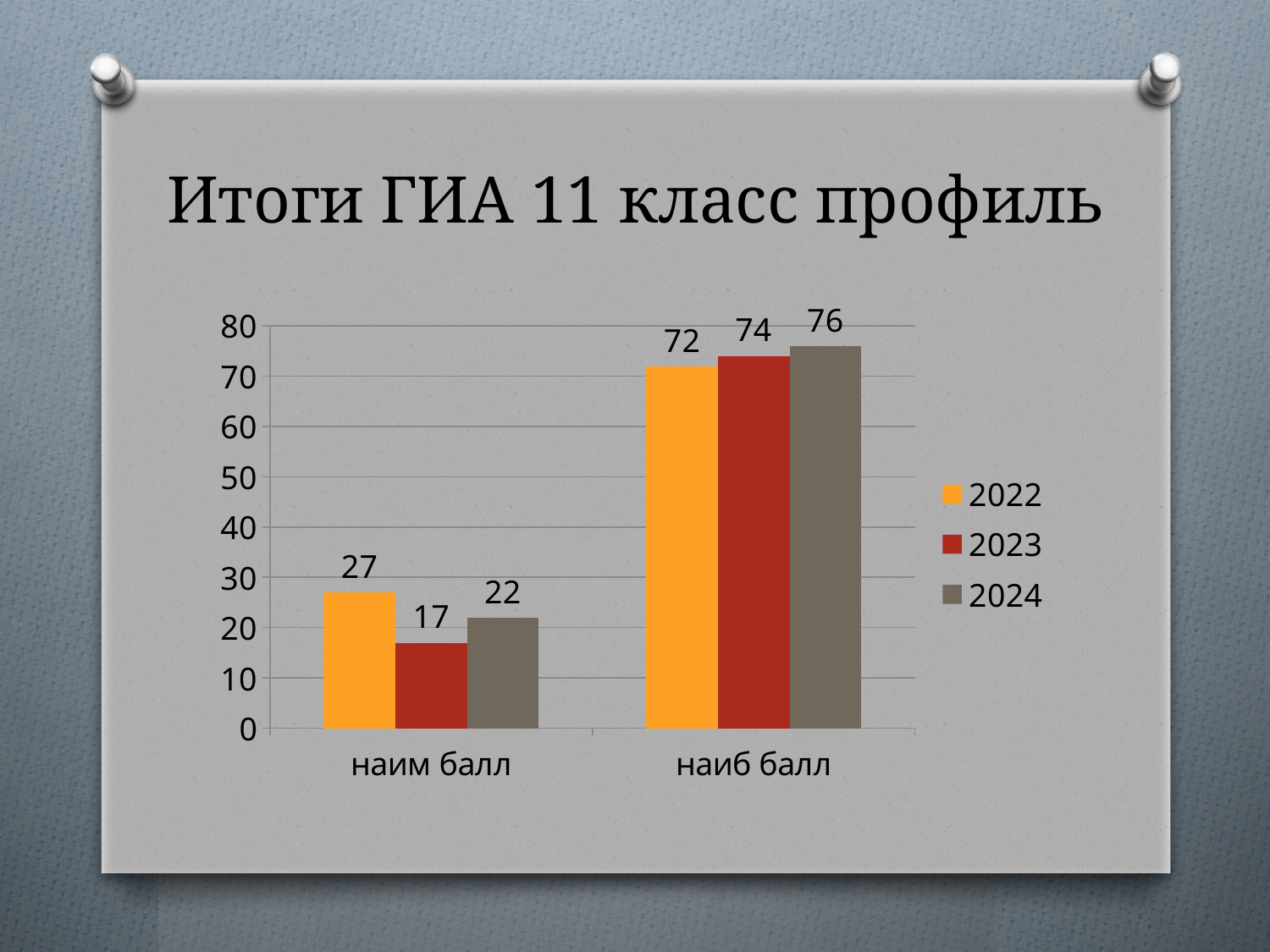
How many categories are shown on the x axis? 2 What is the value for 2024 in the "наиб балл" category? 76 What is the difference between the 2024 and 2023 values in the "наим балл" category? 5 What kind of chart is shown on the slide? Bar chart What is the value for 2023 in the "наим балл" category? 17 What is the value for 2022 in the "наим балл" category? 27 How many series does the legend list? 3 Which year has the highest value in the "наиб балл" category? 2024 Which is larger: the 2022 value or the 2024 value in the "наим балл" category? 2022 What is the difference between the 2022 values for "наиб балл" and "наим балл"? 45 What is the title of the slide? Итоги ГИА 11 класс профиль Which year has the lowest value in the "наим балл" category? 2023